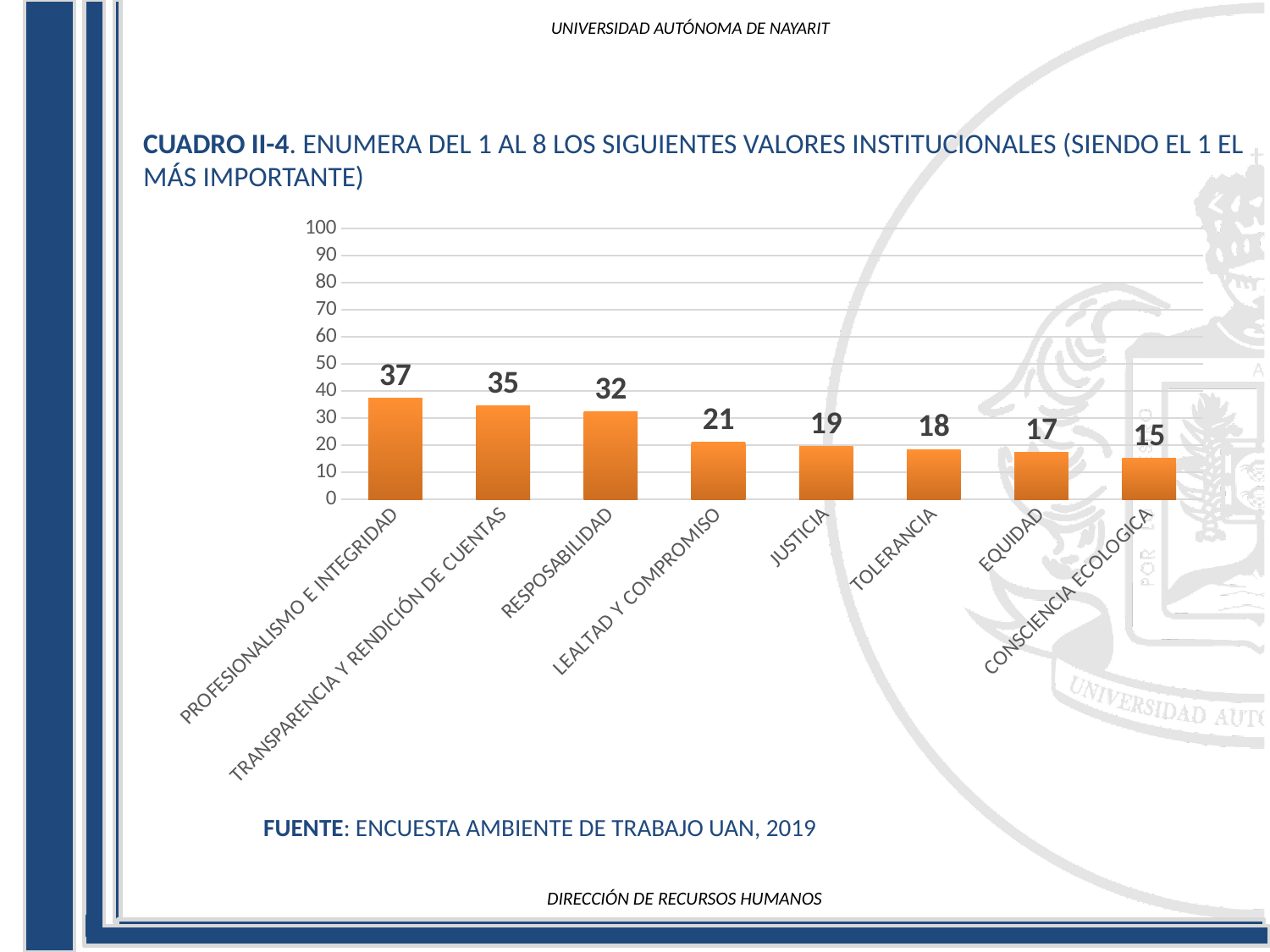
What is the value for PROFESIONALISMO E INTEGRIDAD? 37 Is the value for TOLERANCIA greater or less than 30? less Which is larger, the value for LEALTAD Y COMPROMISO or the value for EQUIDAD? LEALTAD Y COMPROMISO What is the value for CONSCIENCIA ECOLOGICA? 15 What kind of chart is shown on the slide? bar chart What is the value for JUSTICIA? 19 What is the difference between the values for TRANSPARENCIA Y RENDICIÓN DE CUENTAS and RESPOSABILIDAD? 3 Which category has the lowest value? CONSCIENCIA ECOLOGICA Which category has the highest value? PROFESIONALISMO E INTEGRIDAD What is the source cited below the chart? ENCUESTA AMBIENTE DE TRABAJO UAN, 2019 Do the values rise or fall from left to right along the x axis? fall How many categories are shown in the chart? 8